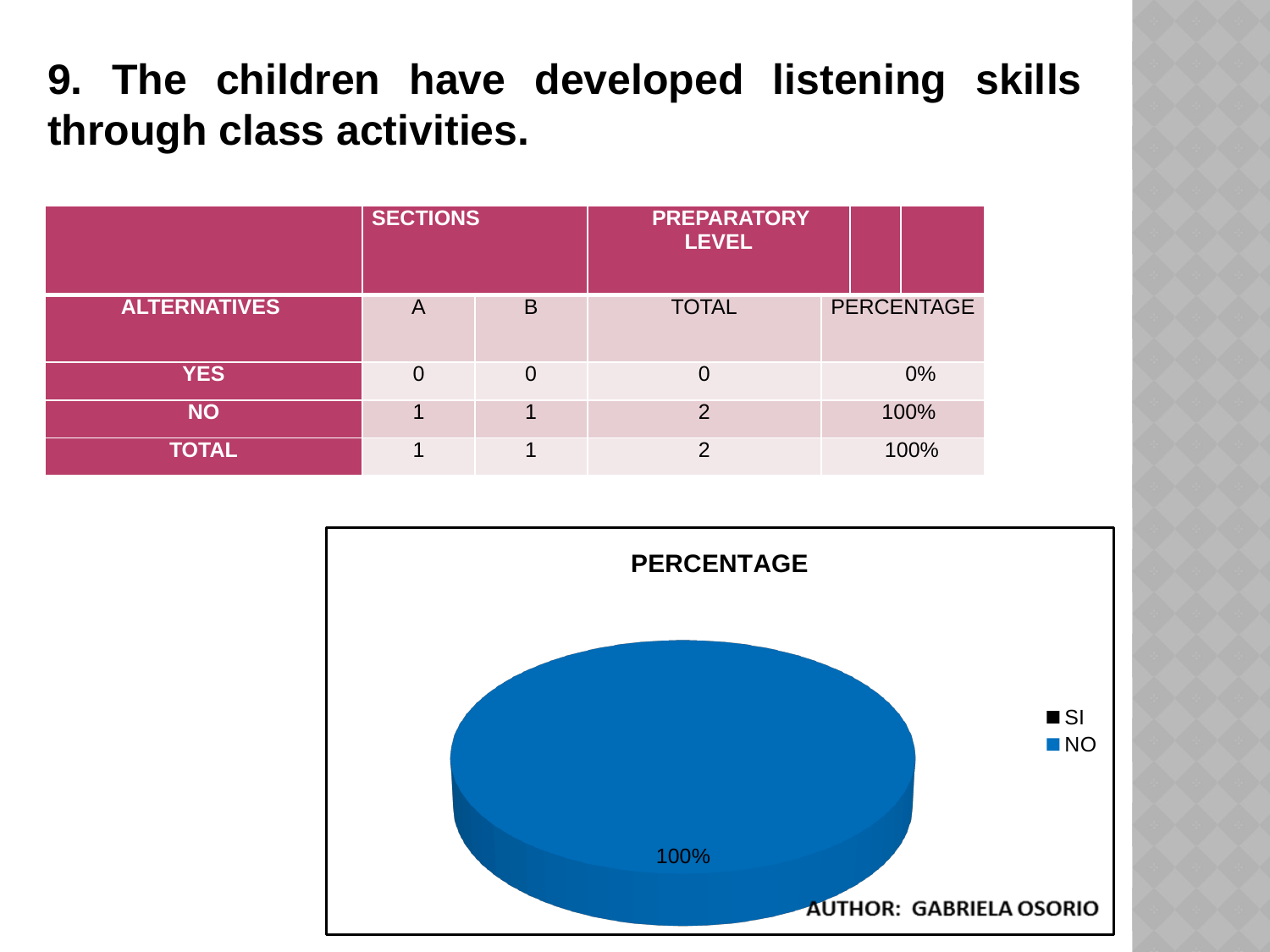
Which is larger in the pie chart, the share for SI or the share for NO? NO How many entries does the chart's legend list? 2 Which category does the blue slice of the pie chart represent? NO What kind of chart is shown on the slide? pie chart Which category has the largest share of the pie chart? NO How many visible slices does the pie chart have? 1 What is the title of the chart? PERCENTAGE Which category has the smallest share of the pie chart? SI What percentage is shown on the pie chart's data label? 100% What share of the pie does the NO category take up? 100%